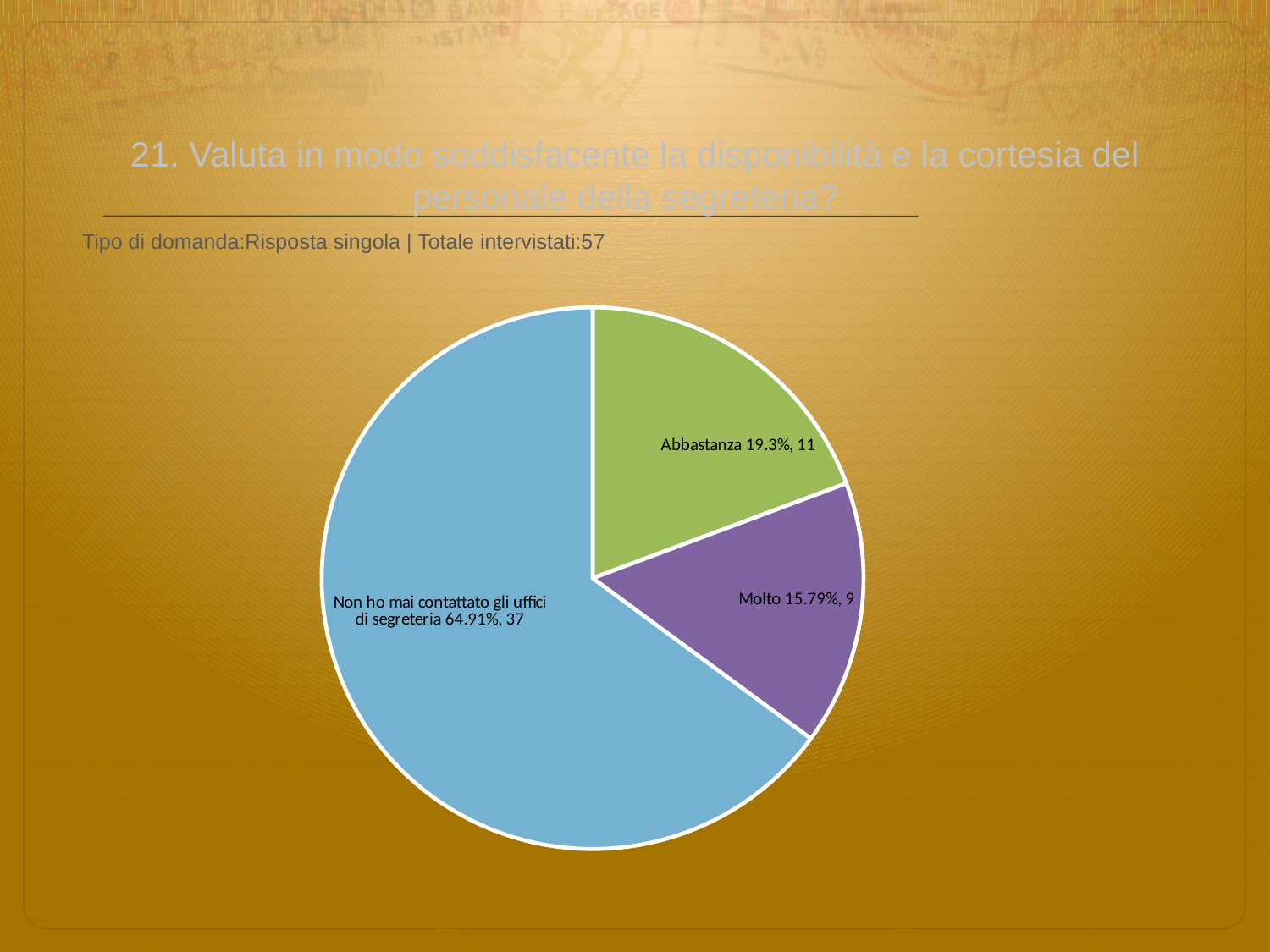
How many respondents chose 'Abbastanza'? 11 Which category has the largest slice of the pie? Non ho mai contattato gli uffici di segreteria How many respondents chose 'Molto'? 9 How many respondents chose 'Non ho mai contattato gli uffici di segreteria'? 37 What is the difference in respondent count between 'Abbastanza' and 'Molto'? 2 Which category has the smallest slice of the pie? Molto What percentage share does the 'Molto' slice have? 15.79% What percentage share does the 'Non ho mai contattato gli uffici di segreteria' slice have? 64.91% How many slices does the pie chart have? 3 What colour is the 'Molto' slice? purple What percentage share does the 'Abbastanza' slice have? 19.3% What kind of chart is shown on the slide? pie chart